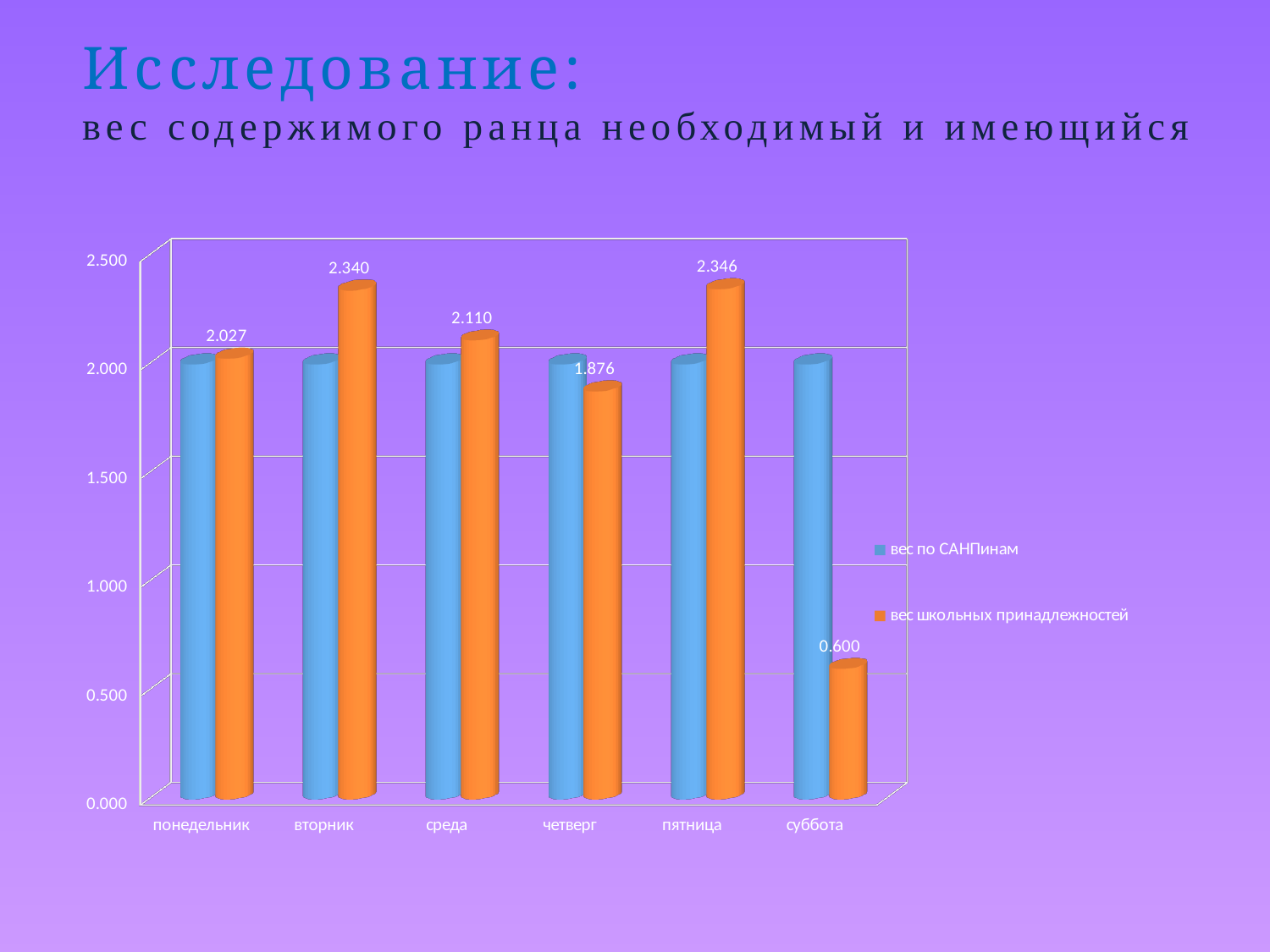
Is the value of вес по САНПинам for понедельник greater or less than 1.500? greater Which is larger, вес школьных принадлежностей for среда or for четверг? среда What is the value of вес школьных принадлежностей for четверг? 1.876 What is the value of вес школьных принадлежностей for суббота? 0.600 What is the value of вес школьных принадлежностей for понедельник? 2.027 What kind of chart is shown on the slide? bar chart What is the difference between вес школьных принадлежностей for вторник and четверг? 0.464 On which day is вес школьных принадлежностей the highest? пятница How many days (categories) are shown on the x axis? 6 On which day is вес школьных принадлежностей the lowest? суббота How many series does the legend list? 2 What is the value of вес школьных принадлежностей for вторник? 2.340